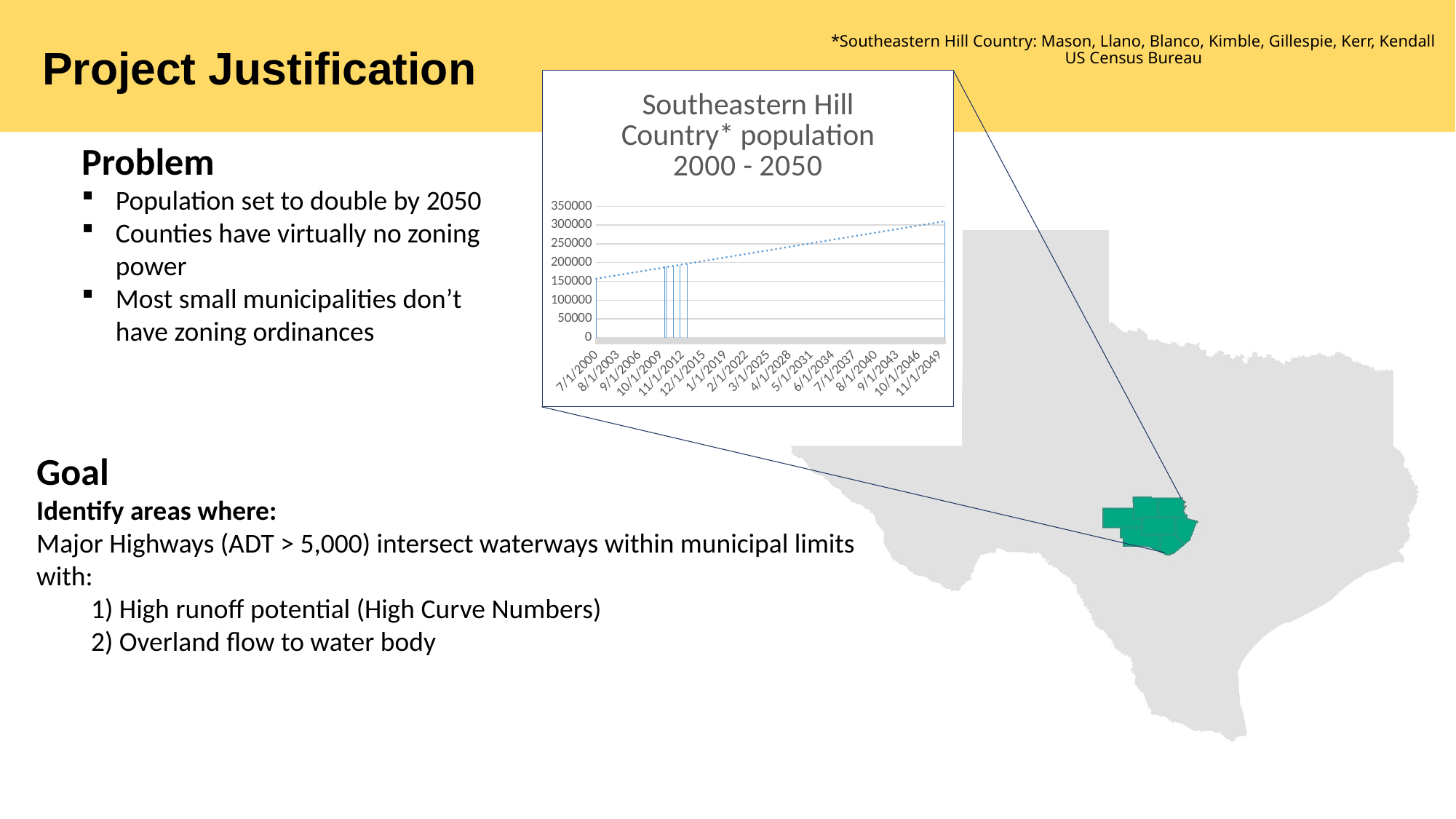
What is the first date label on the x axis of the chart? 7/1/2000 What is the last date label on the x axis of the chart? 11/1/2049 What is the highest value shown on the y axis of the chart? 350000 How many date labels are shown on the x axis of the chart? 17 What kind of chart is shown on the slide? bar chart What is the title of the chart? Southeastern Hill Country* population 2000 - 2050 Do the population values rise or fall along the x axis from 2000 to 2050? rise